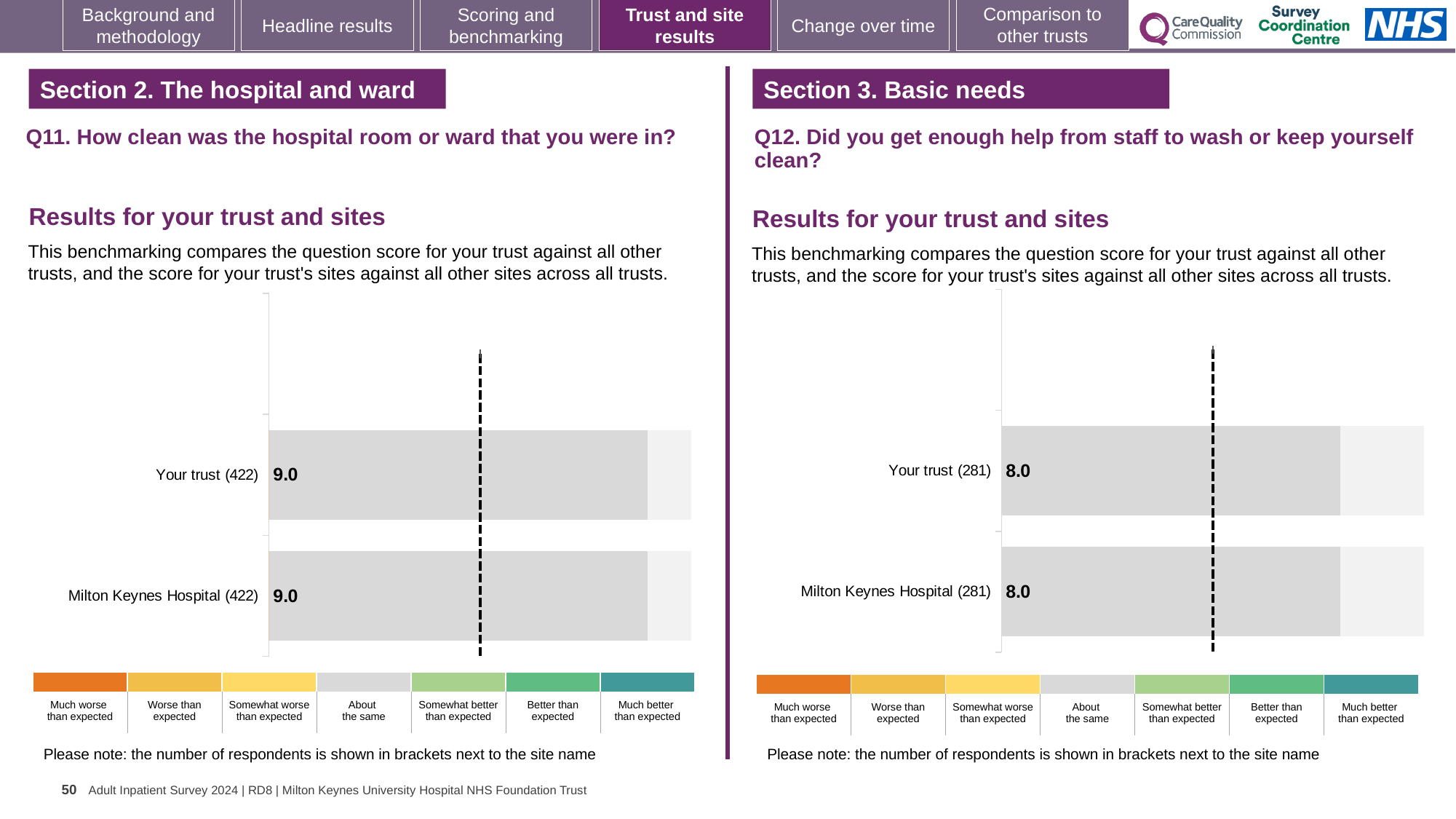
On the Q11 chart (left), how many respondents are shown in brackets next to Your trust? 422 On the Q11 chart (left), what is the score for Milton Keynes Hospital? 9.0 Is the Your trust score on the Q11 chart (left) larger or smaller than the Your trust score on the Q12 chart (right)? Larger On the Q12 chart (right), how many respondents are shown in brackets next to Milton Keynes Hospital? 281 On the Q11 chart (left), what is the score for Your trust? 9.0 How many bars are plotted on the Q11 chart (left)? 2 On the Q12 chart (right), what is the score for Your trust? 8.0 How many bars are plotted on the Q12 chart (right)? 2 On the Q12 chart (right), what is the score for Milton Keynes Hospital? 8.0 On the Q12 chart (right), what is the difference between the Your trust score and the Milton Keynes Hospital score? 0.0 What kind of chart is used for the Q11 results on the left? Bar chart On the Q11 chart (left), what is the difference between the Your trust score and the Milton Keynes Hospital score? 0.0